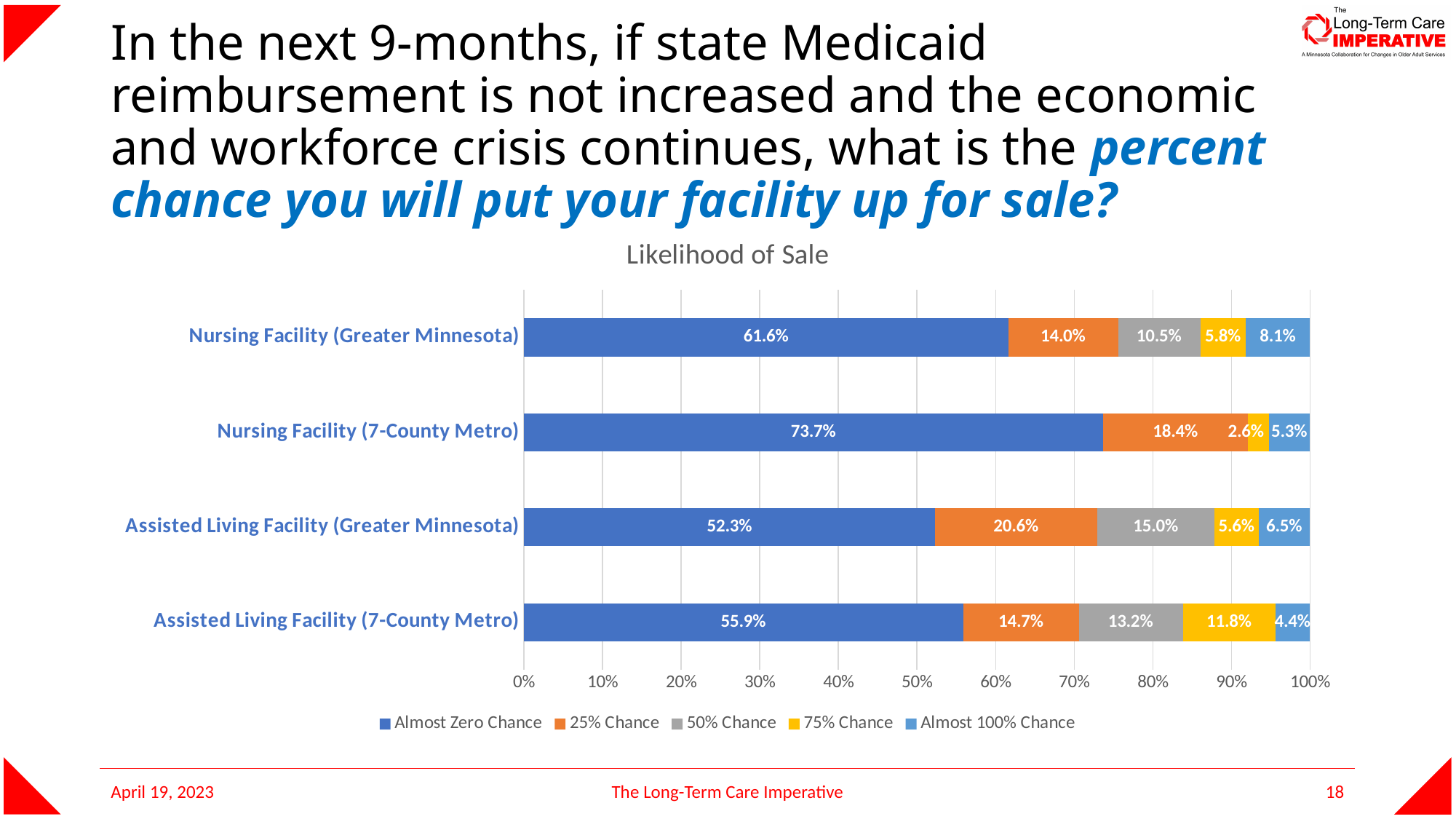
What is the value for Almost 100% Chance for Nursing Facility (Greater Minnesota)? 8.1% Which has the larger 50% Chance value: Assisted Living Facility (Greater Minnesota) or Assisted Living Facility (7-County Metro)? Assisted Living Facility (Greater Minnesota) What is the value for 25% Chance for Assisted Living Facility (Greater Minnesota)? 20.6% Which category has the lowest value for Almost Zero Chance? Assisted Living Facility (Greater Minnesota) How many series does the legend list? 5 What is the difference in the Almost Zero Chance value between Nursing Facility (7-County Metro) and Nursing Facility (Greater Minnesota)? 12.1 percentage points What is the value for 75% Chance for Assisted Living Facility (7-County Metro)? 11.8% How many categories are shown on the chart? 4 What is the value for Almost Zero Chance for Nursing Facility (7-County Metro)? 73.7% What is the value for 50% Chance for Nursing Facility (Greater Minnesota)? 10.5% What kind of chart is shown on the slide? Stacked bar chart Which category has the highest value for Almost Zero Chance? Nursing Facility (7-County Metro)